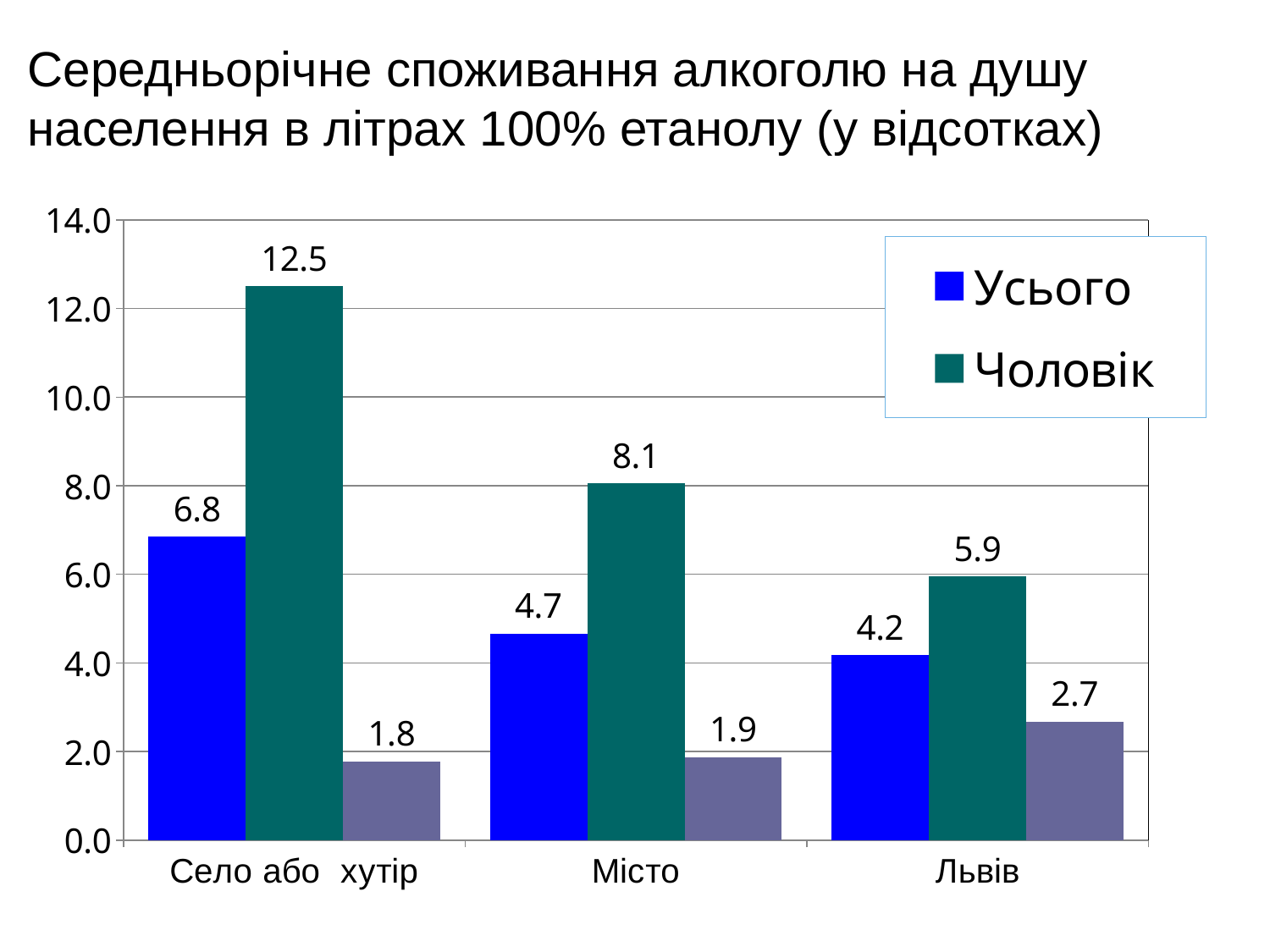
What is the difference between the Чоловік and Усього values in Село або хутір? 5.7 How many categories are shown on the x axis? 3 How many series does the legend list? 2 Which category has the highest value for Чоловік? Село або хутір Is the value for Чоловік in Місто greater or less than 10.0? less What is the value for Усього in Львів? 4.2 What is the difference between the Чоловік values for Місто and Львів? 2.2 What is the value for Чоловік in Львів? 5.9 Which is larger: Усього in Село або хутір or Чоловік in Львів? Усього in Село або хутір What is the value for Чоловік in Село або хутір? 12.5 What is the value for Усього in Місто? 4.7 Which category has the lowest value for Усього? Львів